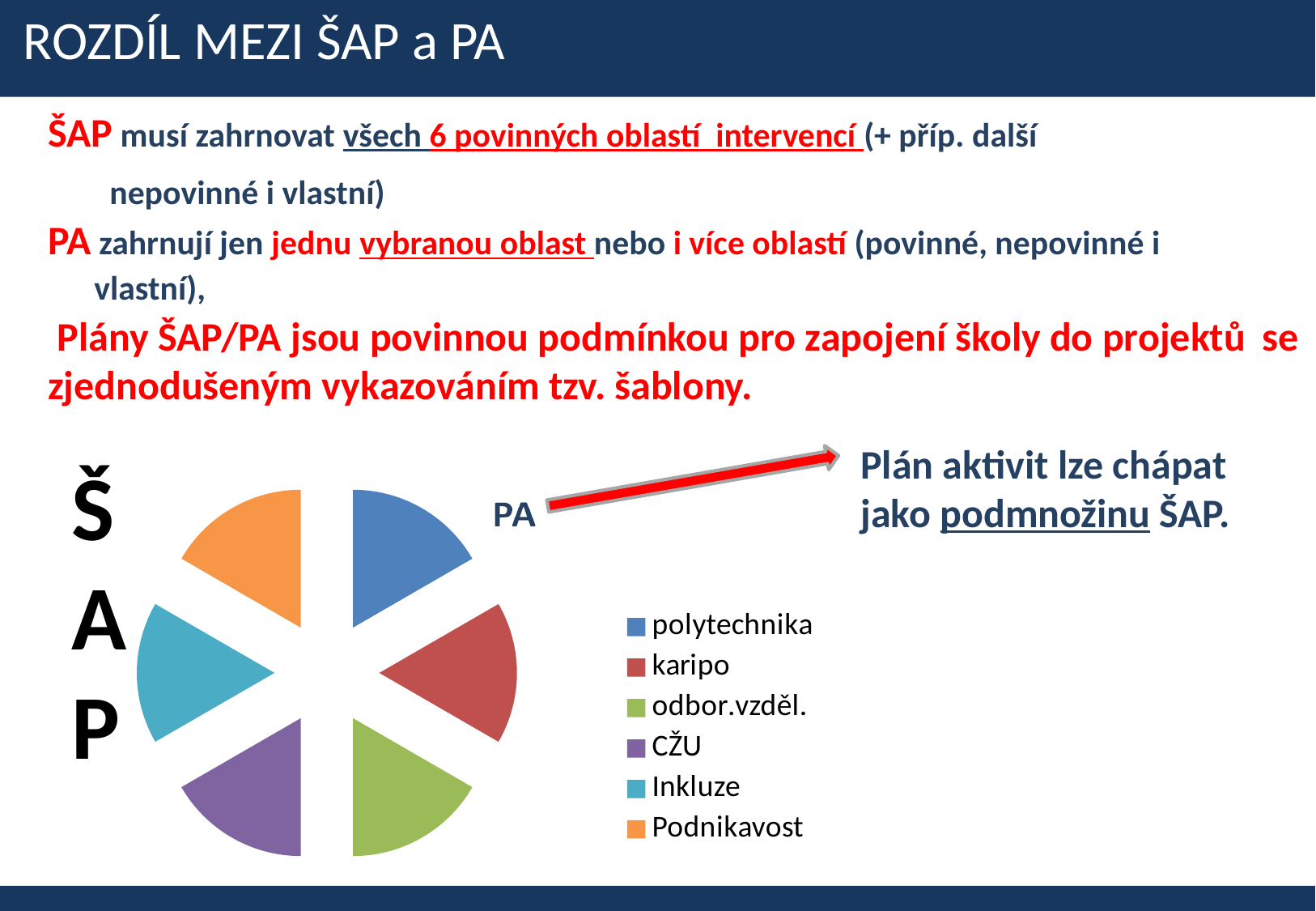
Which legend entry of the pie chart is shown in orange? Podnikavost Which slice of the pie chart is labelled 'PA' by the arrow? polytechnika How many entries does the legend of the pie chart list? 6 Which legend entry of the pie chart is shown in blue? polytechnika What kind of chart is shown on the slide? pie chart How many slices does the pie chart have? 6